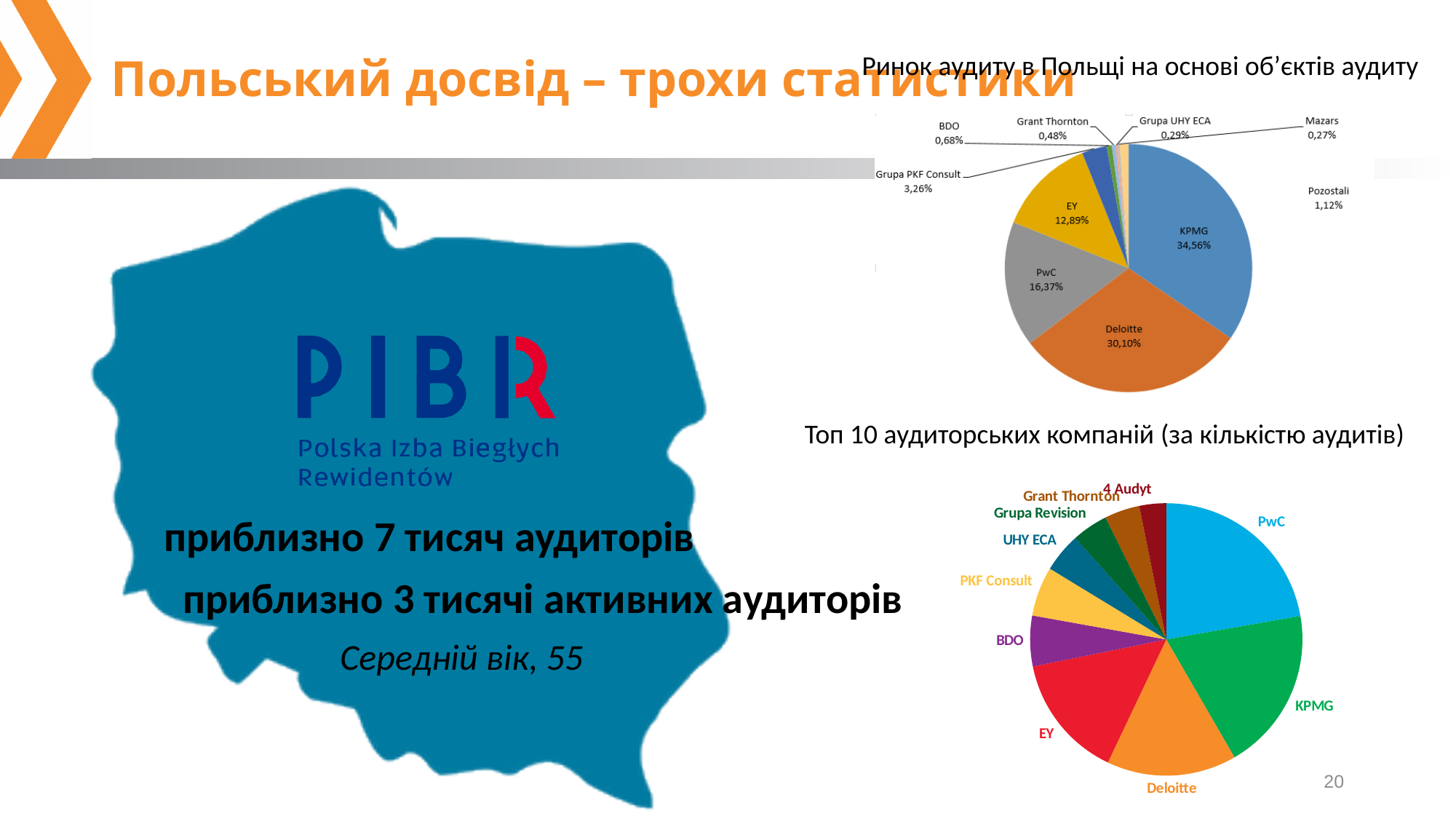
In the top pie chart (Ринок аудиту в Польщі на основі об'єктів аудиту), which labelled slice has the smallest share? Mazars In the top pie chart (Ринок аудиту в Польщі на основі об'єктів аудиту), which company has the largest share? KPMG In the top pie chart (Ринок аудиту в Польщі на основі об'єктів аудиту), which is larger, PwC or EY? PwC In the top pie chart (Ринок аудиту в Польщі на основі об'єктів аудиту), what is the difference in percentage points between KPMG and Deloitte? 4,46 In the top pie chart (Ринок аудиту в Польщі на основі об'єктів аудиту), what share does Deloitte have? 30,10% In the top pie chart (Ринок аудиту в Польщі на основі об'єктів аудиту), how many slices are labelled? 10 In the top pie chart (Ринок аудиту в Польщі на основі об'єктів аудиту), what share does KPMG have? 34,56% In the bottom pie chart (Топ 10 аудиторських компаній), which company is shown in the light blue slice? PwC In the bottom pie chart (Топ 10 аудиторських компаній), how many companies are labelled? 10 What type of chart is the bottom chart (Топ 10 аудиторських компаній)? Pie chart In the top pie chart (Ринок аудиту в Польщі на основі об'єктів аудиту), what share does Grupa PKF Consult have? 3,26% In the top pie chart (Ринок аудиту в Польщі на основі об'єктів аудиту), what share does EY have? 12,89%